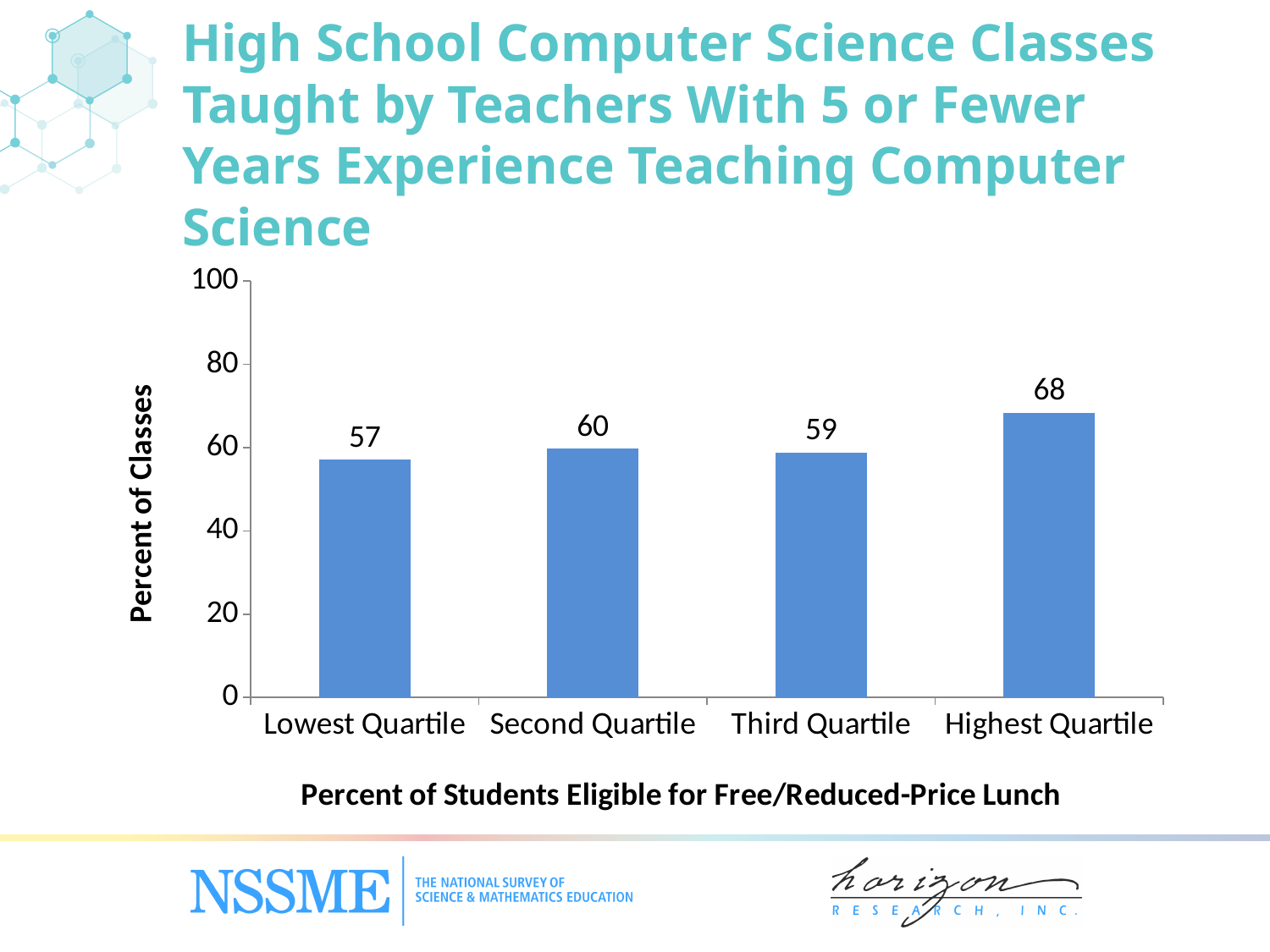
Which is larger, the value for Highest Quartile or the value for Third Quartile? Highest Quartile Which quartile has the highest percent of classes? Highest Quartile What is the difference between the values for Highest Quartile and Lowest Quartile? 11 What is the value for Second Quartile? 60 What is the label of the y axis? Percent of Classes What is the value for Highest Quartile? 68 What is the value for Lowest Quartile? 57 Which quartile has the lowest percent of classes? Lowest Quartile What kind of chart is shown on the slide? bar chart What is the difference between the values for Second Quartile and Third Quartile? 1 Is the value for Highest Quartile greater or less than 60? greater How many quartile categories are shown on the x axis? 4